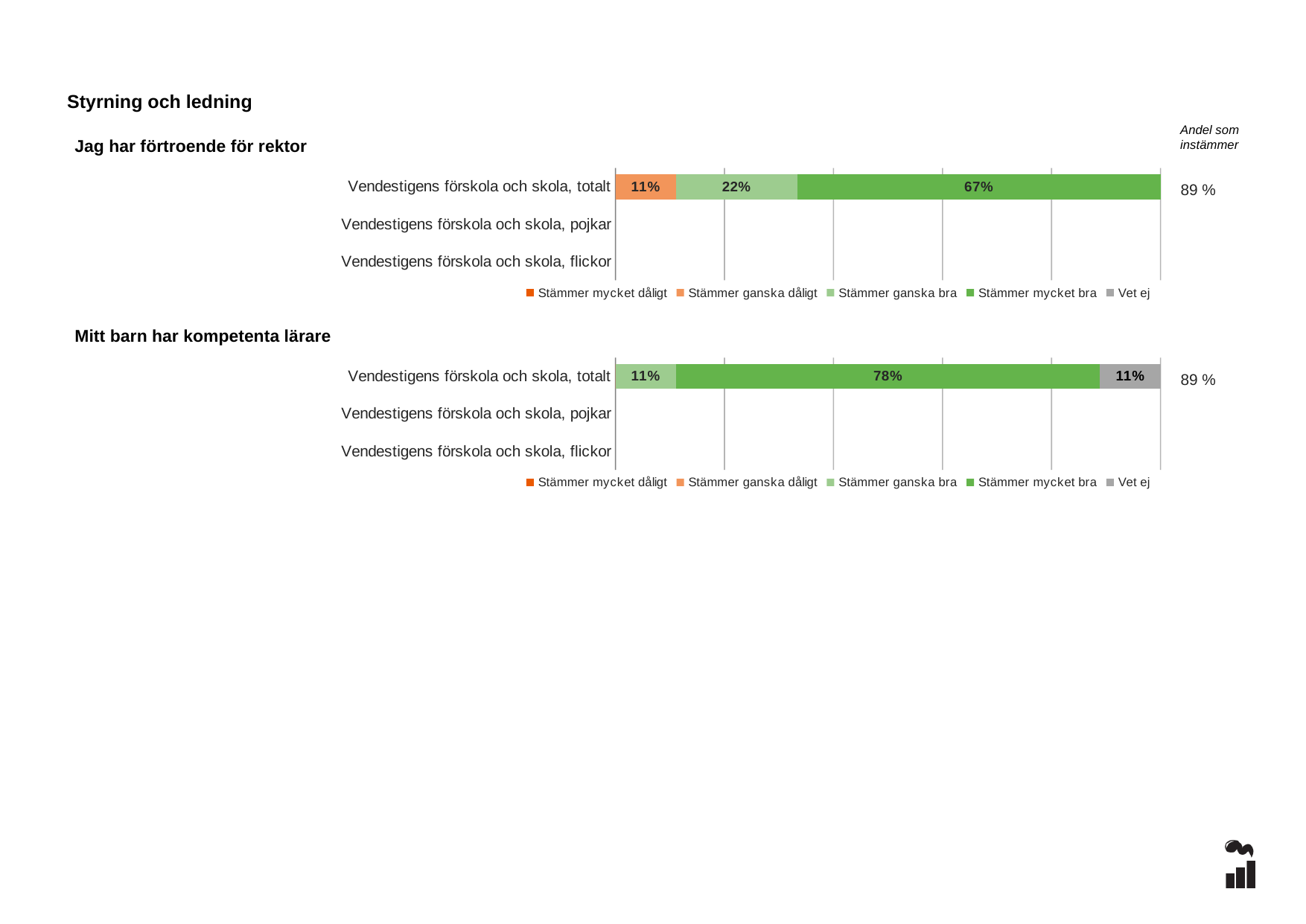
In the chart 'Mitt barn har kompetenta lärare', what is the value for 'Stämmer mycket bra' for 'Vendestigens förskola och skola, totalt'? 78% What kind of chart is 'Mitt barn har kompetenta lärare'? Stacked bar chart In the chart 'Jag har förtroende för rektor', what is the difference between 'Stämmer mycket bra' and 'Stämmer ganska bra' for 'Vendestigens förskola och skola, totalt'? 45% In the chart 'Jag har förtroende för rektor', which series has the largest share for 'Vendestigens förskola och skola, totalt'? Stämmer mycket bra How many categories are shown on the y axis of the chart 'Mitt barn har kompetenta lärare'? 3 In the chart 'Jag har förtroende för rektor', what is the value for 'Stämmer ganska dåligt' for 'Vendestigens förskola och skola, totalt'? 11% In the chart 'Mitt barn har kompetenta lärare', what is the value for 'Vet ej' for 'Vendestigens förskola och skola, totalt'? 11% In the chart 'Jag har förtroende för rektor', what is the value for 'Stämmer mycket bra' for 'Vendestigens förskola och skola, totalt'? 67% Which is larger: 'Stämmer mycket bra' for totalt in 'Jag har förtroende för rektor' or 'Stämmer mycket bra' for totalt in 'Mitt barn har kompetenta lärare'? Mitt barn har kompetenta lärare In the chart 'Jag har förtroende för rektor', what is the value for 'Stämmer ganska bra' for 'Vendestigens förskola och skola, totalt'? 22% In the chart 'Mitt barn har kompetenta lärare', what is the difference between 'Stämmer mycket bra' and 'Stämmer ganska bra' for 'Vendestigens förskola och skola, totalt'? 67% How many series does the legend of the chart 'Jag har förtroende för rektor' list? 5